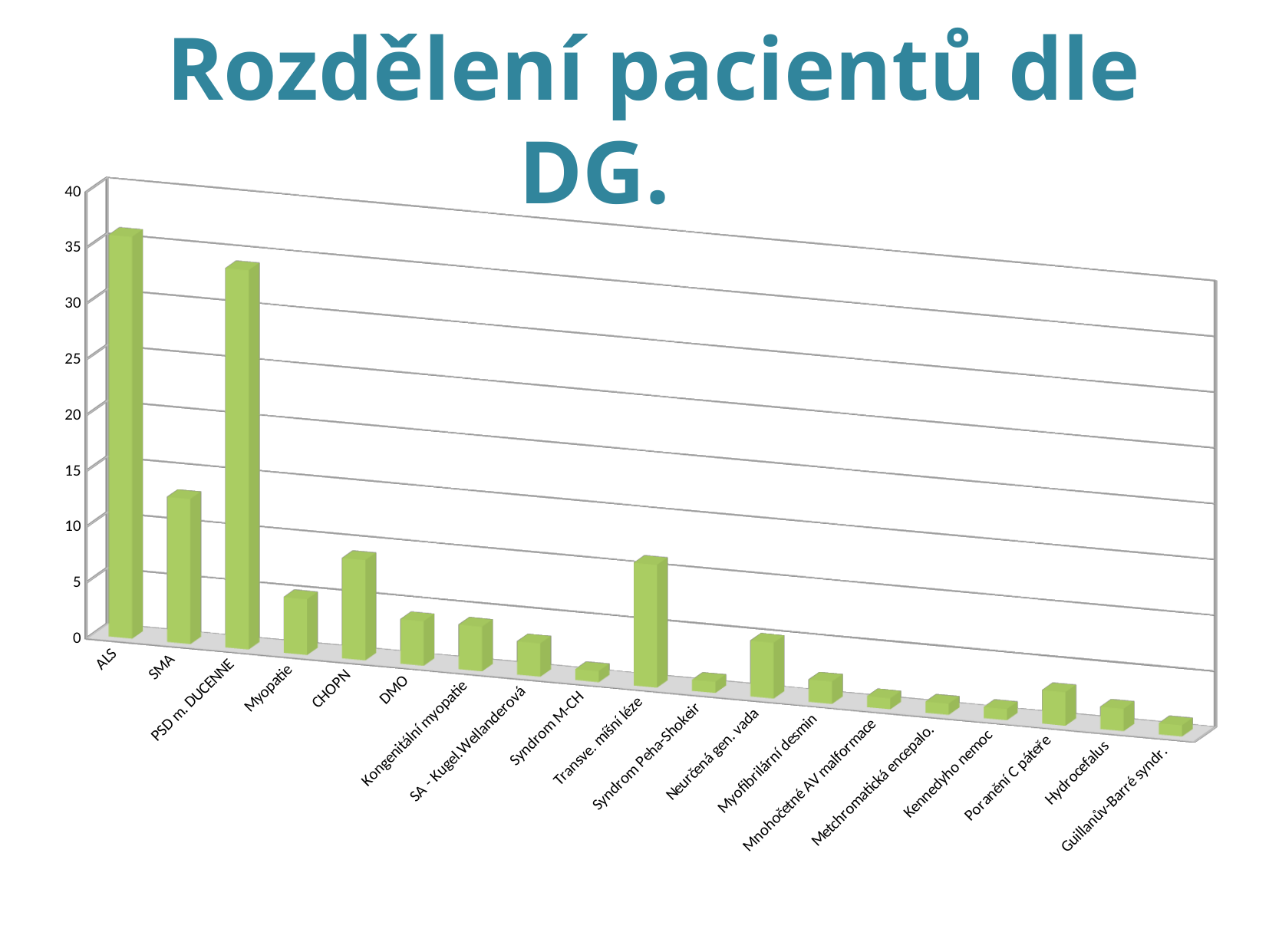
What is the title of the chart on the slide? Rozdělení pacientů dle DG. How many categories are plotted on the x axis of the chart? 19 Which is larger, the value for CHOPN or the value for Myopatie? CHOPN Which is larger, the value for PSD m. DUCENNE or the value for SMA? PSD m. DUCENNE Which is larger, the value for ALS or the value for SMA? ALS Which category has the highest value in the chart? ALS Is the value for SMA greater or less than 20? less What kind of chart is shown on the slide? bar chart Is the value for ALS greater or less than 30? greater Is the value for Transve. míšní léze greater or less than 15? less